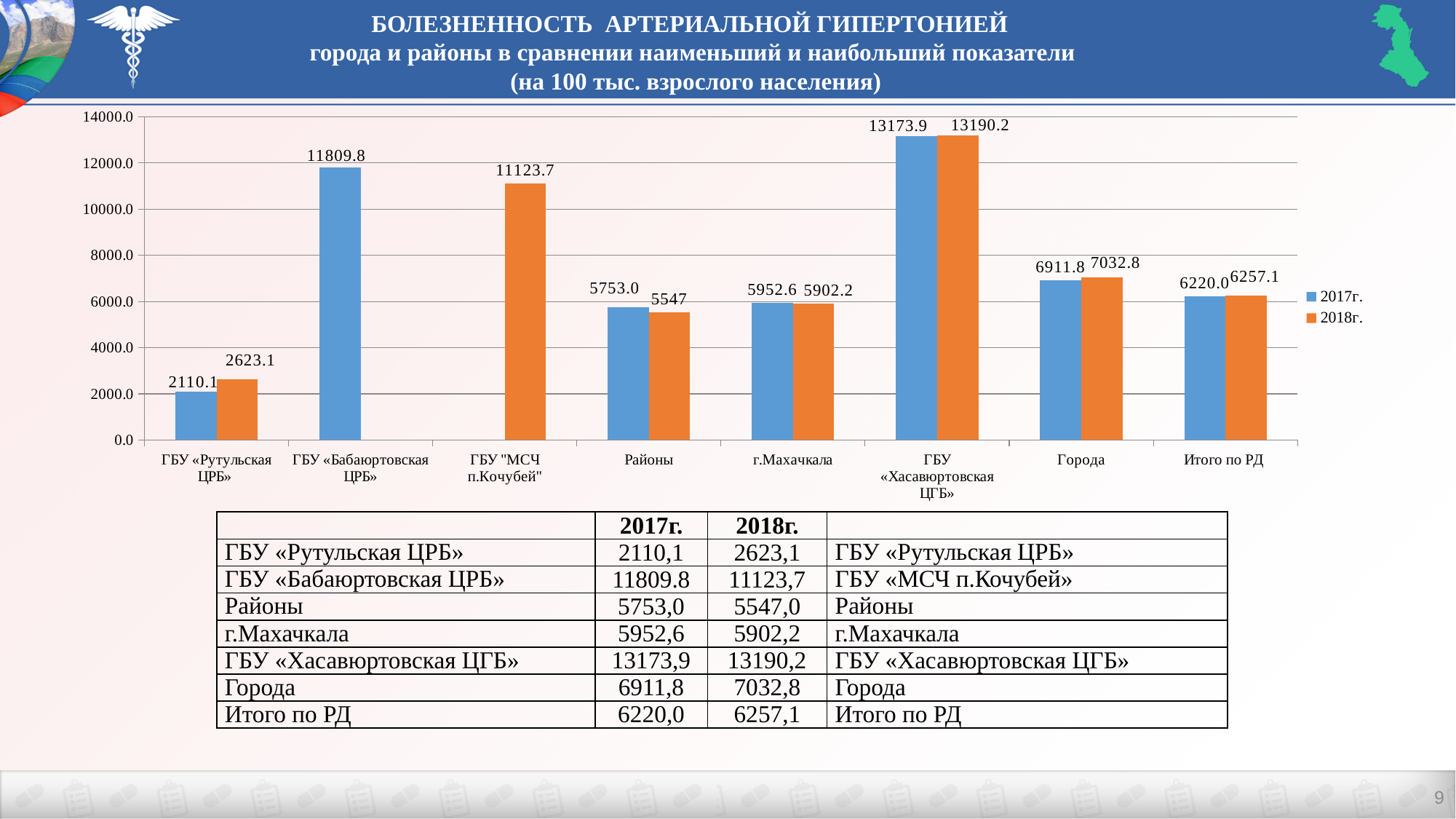
How many series does the legend list? 2 What is the difference between the 2018г. and 2017г. values for Города? 121.0 What is the 2018г. value for Итого по РД? 6257.1 What is the 2018г. value for Города? 7032.8 Is the 2017г. value for ГБУ «Бабаюртовская ЦРБ» greater or less than 12000.0? less Which category has the lowest 2017г. value? ГБУ «Рутульская ЦРБ» Which category has the highest 2018г. value? ГБУ «Хасавюртовская ЦГБ» What kind of chart is shown on the slide? bar chart By how much did the value for ГБУ «Рутульская ЦРБ» increase from 2017г. to 2018г.? 513.0 For Районы, which year has the larger value, 2017г. or 2018г.? 2017г. What is the 2017г. value for Районы? 5753.0 How many categories are shown on the x axis of the chart? 8